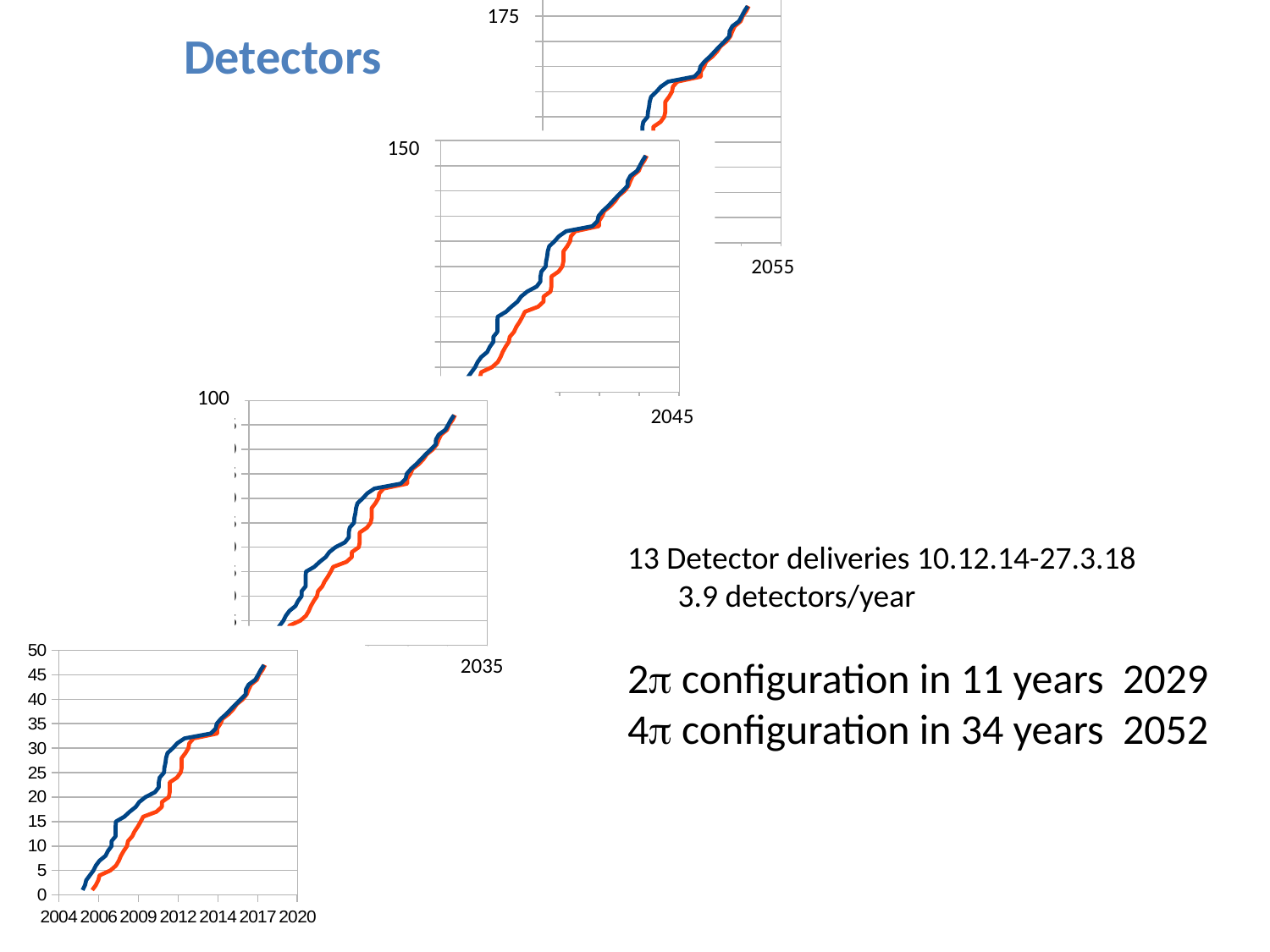
What is the last year label shown on the x axis of the top-right chart? 2055 In the bottom-left chart, is the value of the red line at 2009 greater or less than 20? less In the bottom-left chart, is the value of the blue line at 2006 greater or less than 10? less In the bottom-left chart, at 2009, which line has the higher value, the blue line or the red line? blue line What is the highest value shown on the y axis of the bottom-left chart? 50 How many year labels are shown on the x axis of the bottom-left chart? 7 In the bottom-left chart, is the value of the blue line at 2012 greater or less than 25? greater How many lines are plotted in the bottom-left chart? 2 What kind of chart is shown in the bottom-left of the slide? line chart In the bottom-left chart, do the plotted values rise or fall as the years increase from 2004 to 2020? rise What is the first year label on the x axis of the bottom-left chart? 2004